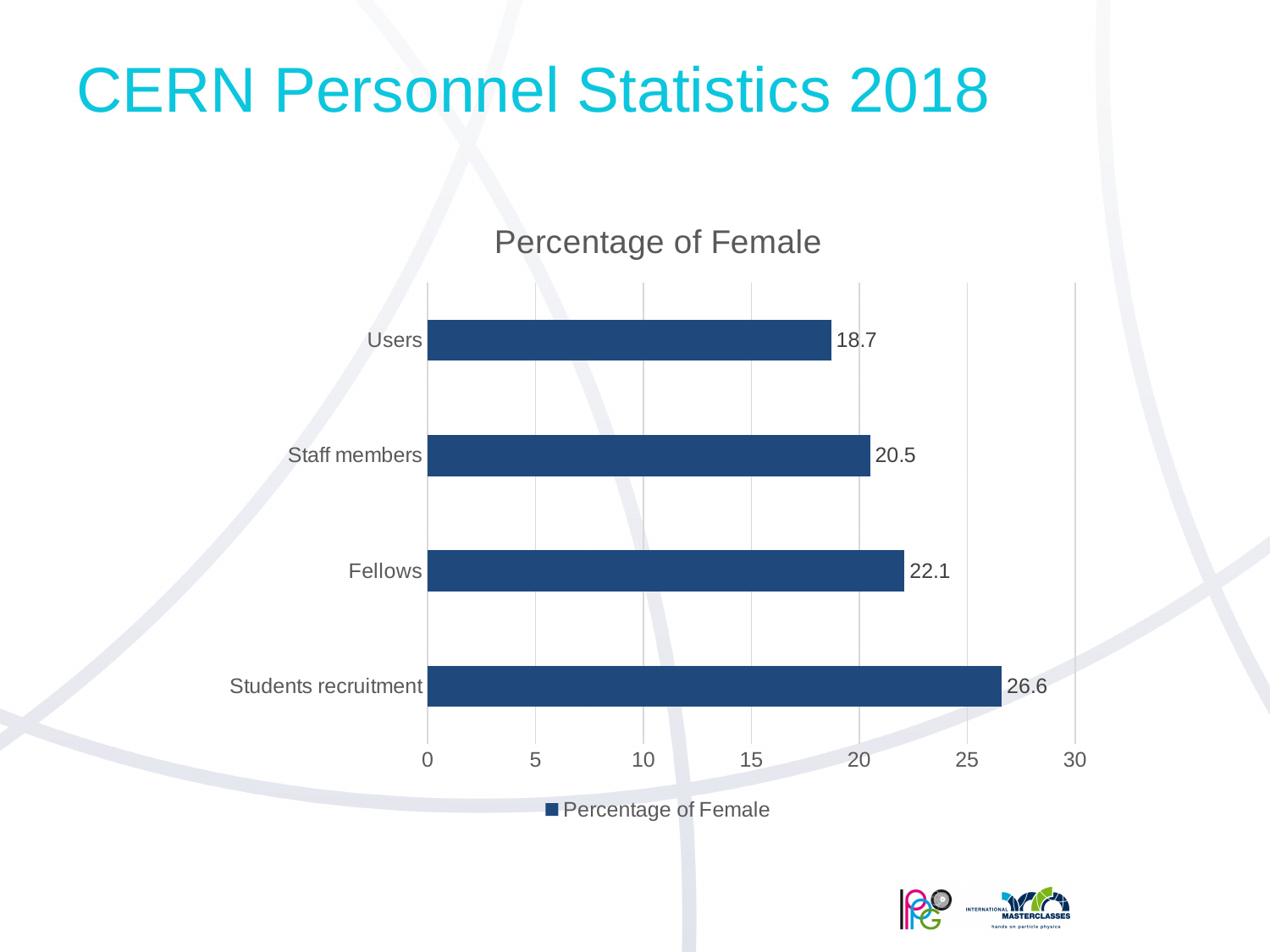
What is the percentage of female for Students recruitment? 26.6 What is the percentage of female for Staff members? 20.5 Which has a higher percentage of female, Staff members or Fellows? Fellows What is the title of the chart? Percentage of Female What is the difference between the percentage of female for Students recruitment and for Users? 7.9 What type of chart is shown on the slide? Bar chart What is the percentage of female for Fellows? 22.1 How many categories are shown in the chart? 4 Which category has the highest percentage of female? Students recruitment What is the difference between the percentage of female for Fellows and for Staff members? 1.6 What is the percentage of female for Users? 18.7 Which category has the lowest percentage of female? Users